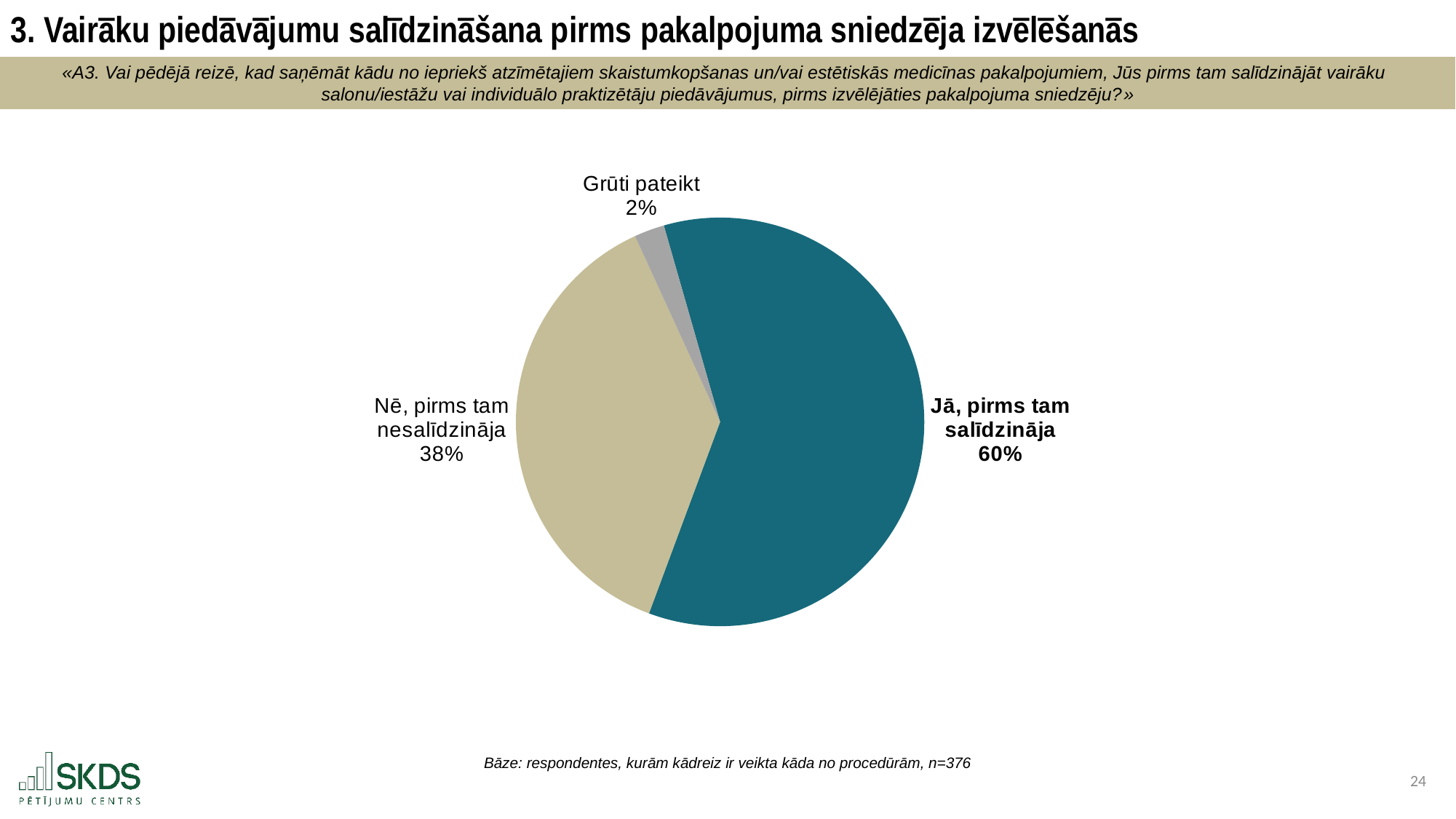
What is the sample size (n) stated in the base note below the chart? n=376 Which answer has the largest share of the pie? Jā, pirms tam salīdzināja What colour is the slice for "Jā, pirms tam salīdzināja"? teal (dark blue-green) What is the combined share of "Nē, pirms tam nesalīdzināja" and "Grūti pateikt"? 40% What share of respondents answered "Grūti pateikt"? 2% Which answer has the smallest share of the pie? Grūti pateikt What is the difference in percentage points between "Jā, pirms tam salīdzināja" and "Nē, pirms tam nesalīdzināja"? 22 percentage points What share of respondents answered "Jā, pirms tam salīdzināja"? 60% What share of respondents answered "Nē, pirms tam nesalīdzināja"? 38% How many slices does the pie chart have? 3 What kind of chart is shown on the slide? pie chart Which is larger: the share for "Nē, pirms tam nesalīdzināja" or the share for "Grūti pateikt"? Nē, pirms tam nesalīdzināja